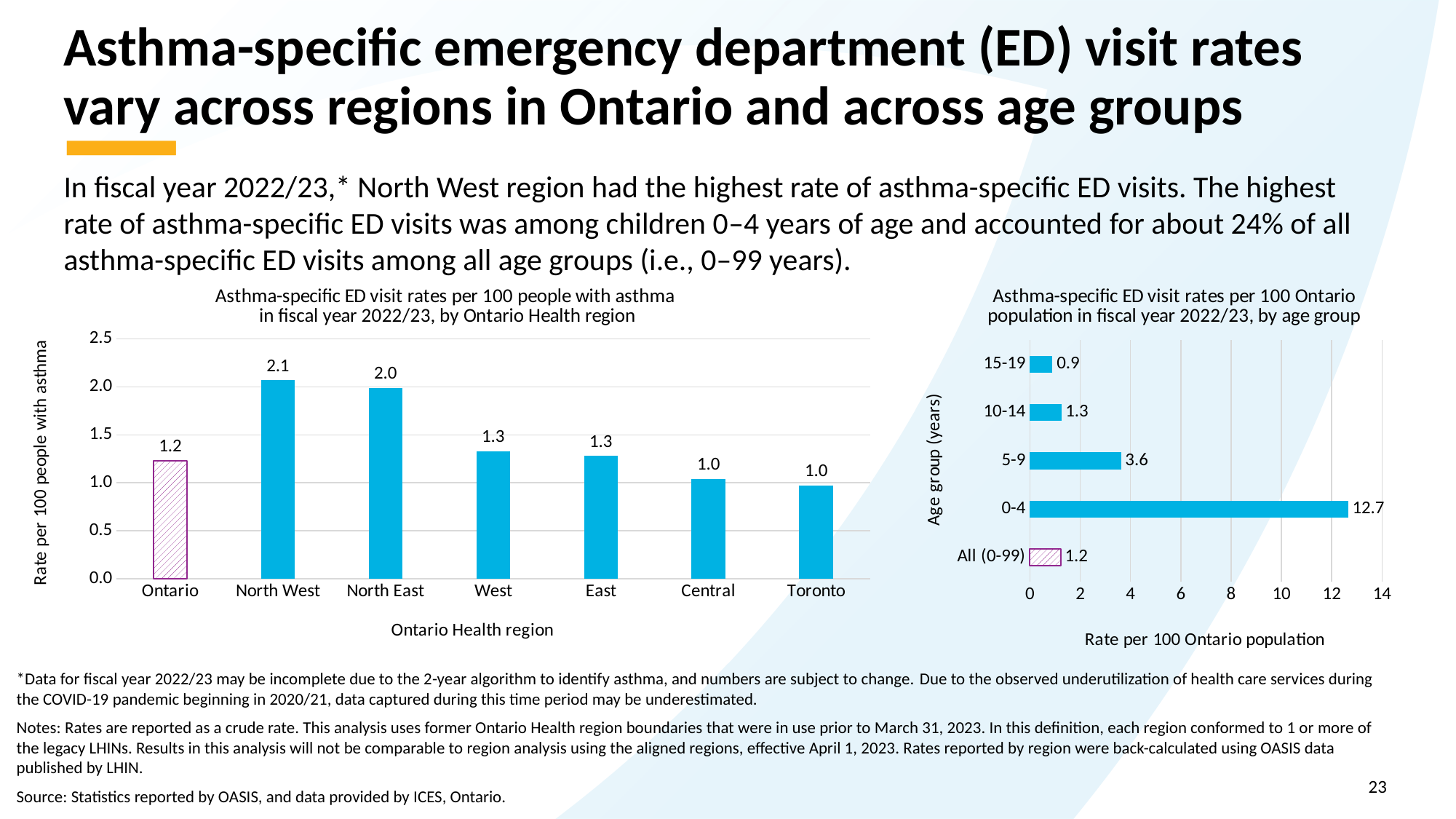
In the chart by age group, what is the difference between the 0-4 rate and the 5-9 rate? 9.1 In the chart by age group, what is the ED visit rate for the 0-4 age group? 12.7 In the chart by Ontario Health region, what is the difference between the North West rate and the Toronto rate? 1.1 What is the x-axis title of the chart by age group? Rate per 100 Ontario population In the chart by Ontario Health region, how many categories are shown on the x axis? 7 In the chart by Ontario Health region, what is the rate for Ontario overall? 1.2 What kind of chart is the chart by age group? Bar chart In the chart by Ontario Health region, what is the asthma-specific ED visit rate for North West? 2.1 In the chart by Ontario Health region, is the value for North East greater or less than 1.5? greater In the chart by age group, which age group has the lowest rate? 15-19 In the chart by age group, which is larger, the rate for 10-14 or the rate for 15-19? 10-14 In the chart by Ontario Health region, which region has the highest rate? North West